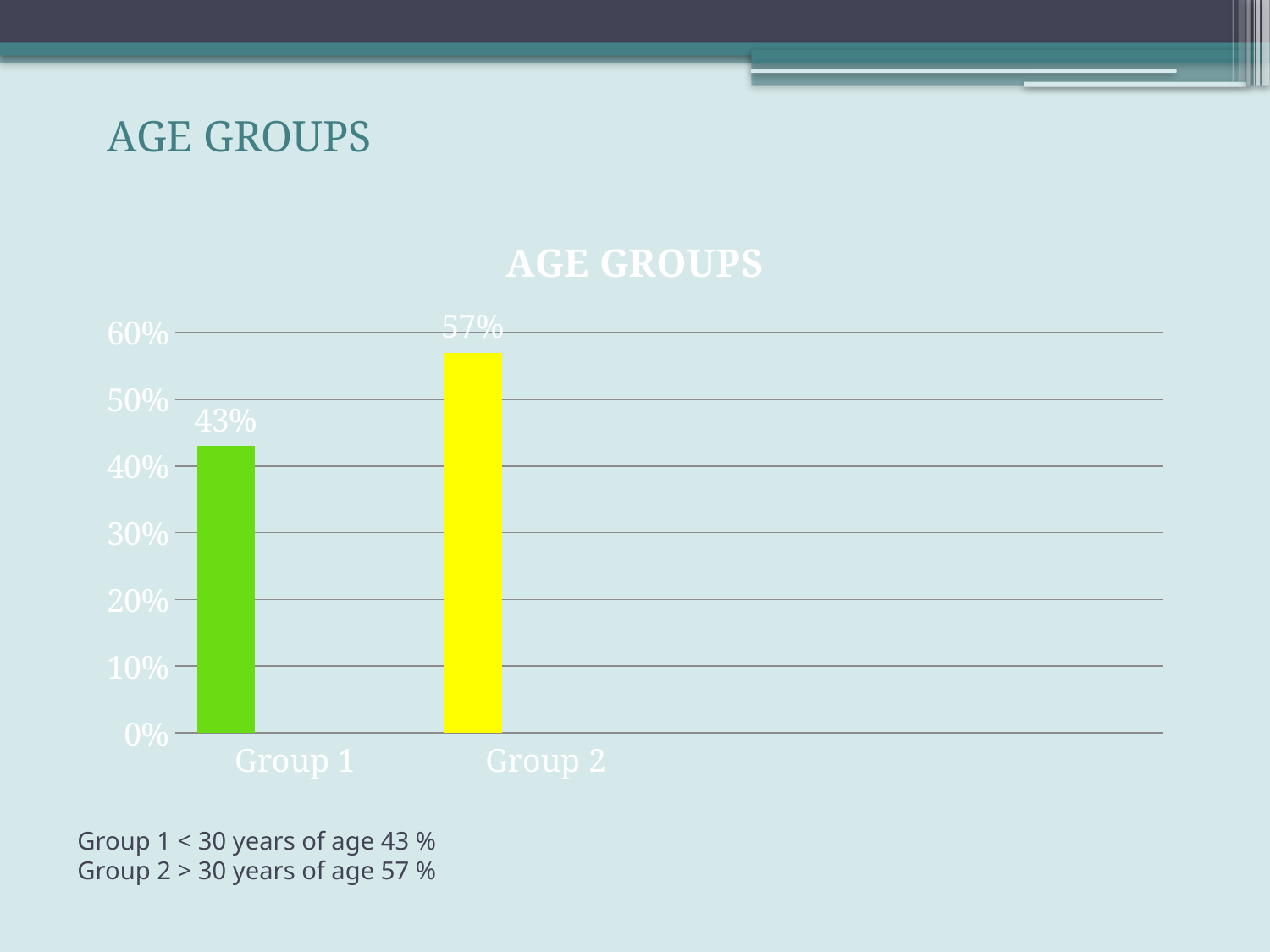
Is the value for Group 1 greater or less than 50%? less Which group has the highest value? Group 2 Which is larger, the value for Group 1 or the value for Group 2? Group 2 What is the title of the chart? AGE GROUPS What kind of chart is shown on the slide? bar chart What is the value for Group 2? 57% Which group has the lowest value? Group 1 How many categories are shown on the chart? 2 What is the value for Group 1? 43% Is the value for Group 2 greater or less than 50%? greater What colour is the bar for Group 2? yellow What is the difference between the values for Group 2 and Group 1? 14%